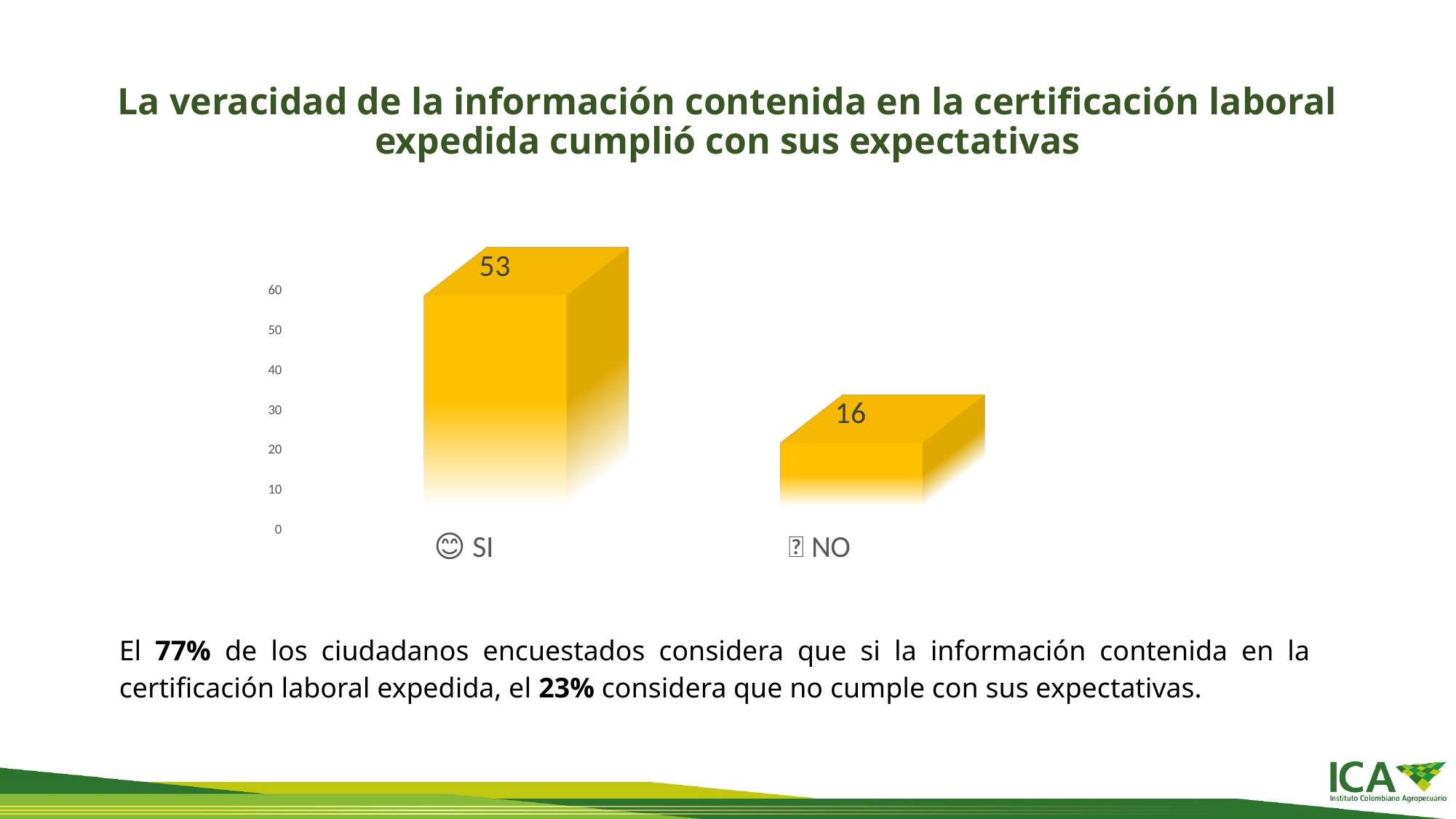
Which category has the lowest value? NO Which is larger, the value for SI or the value for NO? SI What is the total of the two values shown in the chart? 69 Is the value for SI greater or less than 50? greater What kind of chart is shown on the slide? bar chart Which category has the highest value? SI How many categories are shown in the chart? 2 Is the value for NO greater or less than 20? less What is the highest value shown on the vertical axis? 60 What is the value for SI? 53 What is the difference between the values for SI and NO? 37 What is the value for NO? 16